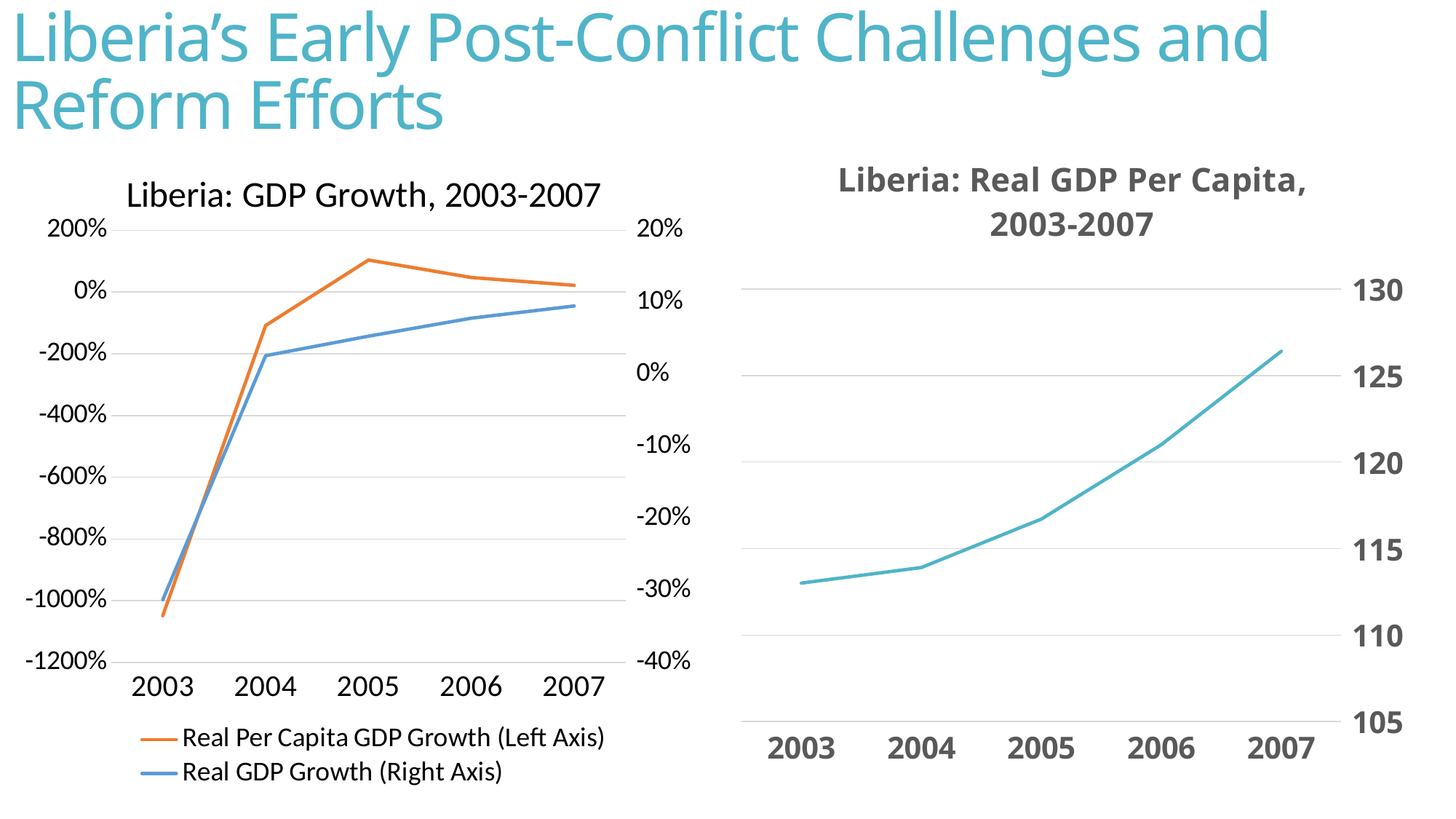
How many years are plotted on the 'Liberia: Real GDP Per Capita, 2003-2007' chart? 5 In the 'Liberia: Real GDP Per Capita, 2003-2007' chart, do the values rise or fall from 2003 to 2007? rise How many series does the legend of the 'Liberia: GDP Growth, 2003-2007' chart list? 2 In the 'Liberia: GDP Growth, 2003-2007' chart, which axis does the Real GDP Growth series use according to the legend? Right Axis In the 'Liberia: GDP Growth, 2003-2007' chart, is the Real Per Capita GDP Growth value for 2003 greater or less than -800%? less In the 'Liberia: GDP Growth, 2003-2007' chart, which year has the highest Real Per Capita GDP Growth? 2005 In the 'Liberia: Real GDP Per Capita, 2003-2007' chart, which year has the lowest value? 2003 What kind of chart is the 'Liberia: Real GDP Per Capita, 2003-2007' chart? line chart In the 'Liberia: Real GDP Per Capita, 2003-2007' chart, is the value for 2003 greater or less than 115? less In the 'Liberia: Real GDP Per Capita, 2003-2007' chart, which year has the highest value? 2007 In the 'Liberia: GDP Growth, 2003-2007' chart, is the Real GDP Growth value for 2003 greater or less than -20%? less